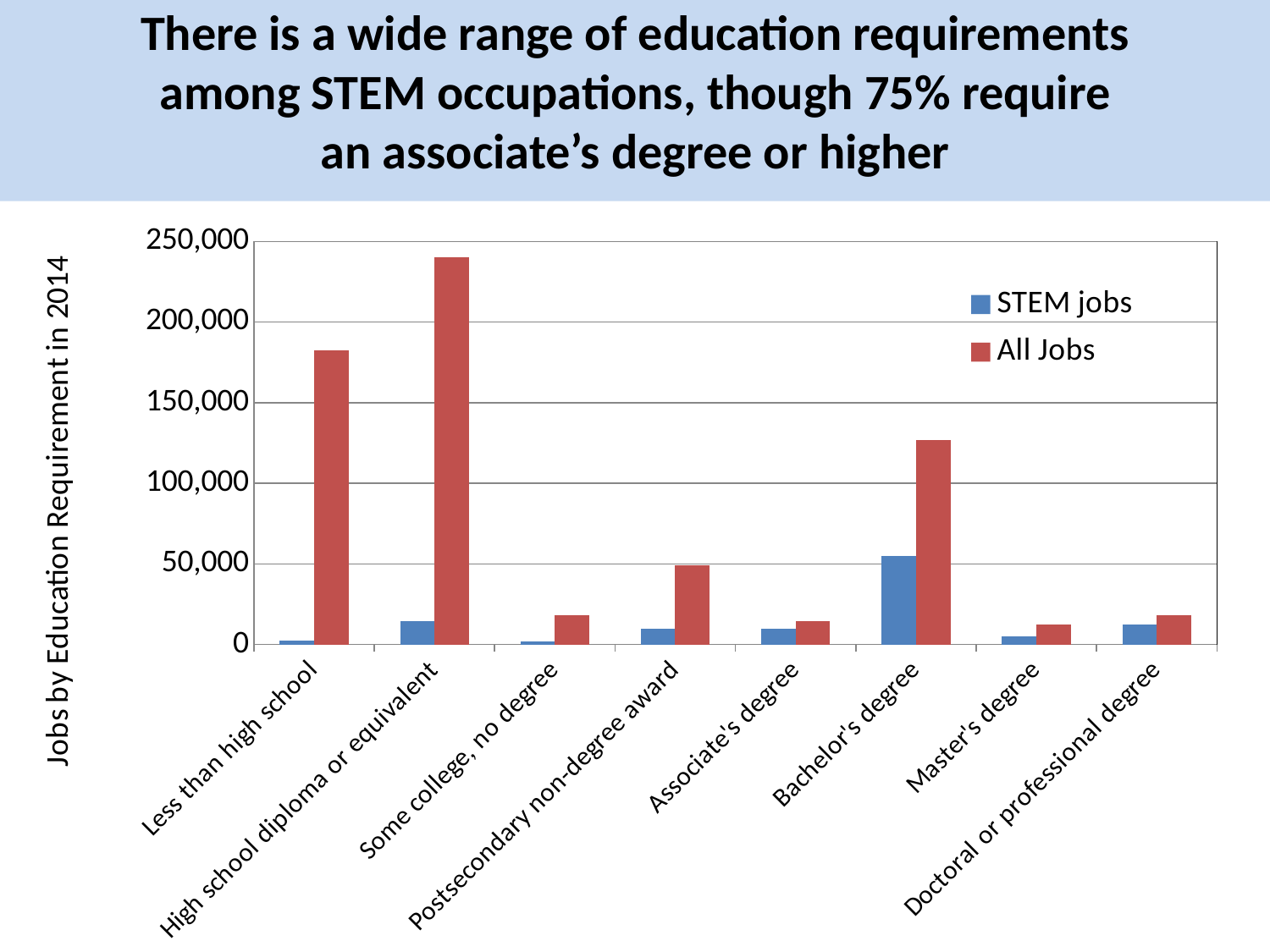
Which education requirement category has the highest value for All Jobs? High school diploma or equivalent Is the STEM jobs value for Bachelor's degree greater or less than 100,000? less For STEM jobs, which is larger: the value for Bachelor's degree or the value for High school diploma or equivalent? Bachelor's degree Which education requirement category has the highest value for STEM jobs? Bachelor's degree Is the All Jobs value for Less than high school greater or less than 150,000? greater How many series does the legend list? 2 For Bachelor's degree, which series has the larger value, STEM jobs or All Jobs? All Jobs How many education requirement categories are shown on the x axis? 8 What kind of chart is shown on the slide? bar chart Is the All Jobs value for Bachelor's degree greater or less than 100,000? greater What is the title of the vertical axis? Jobs by Education Requirement in 2014